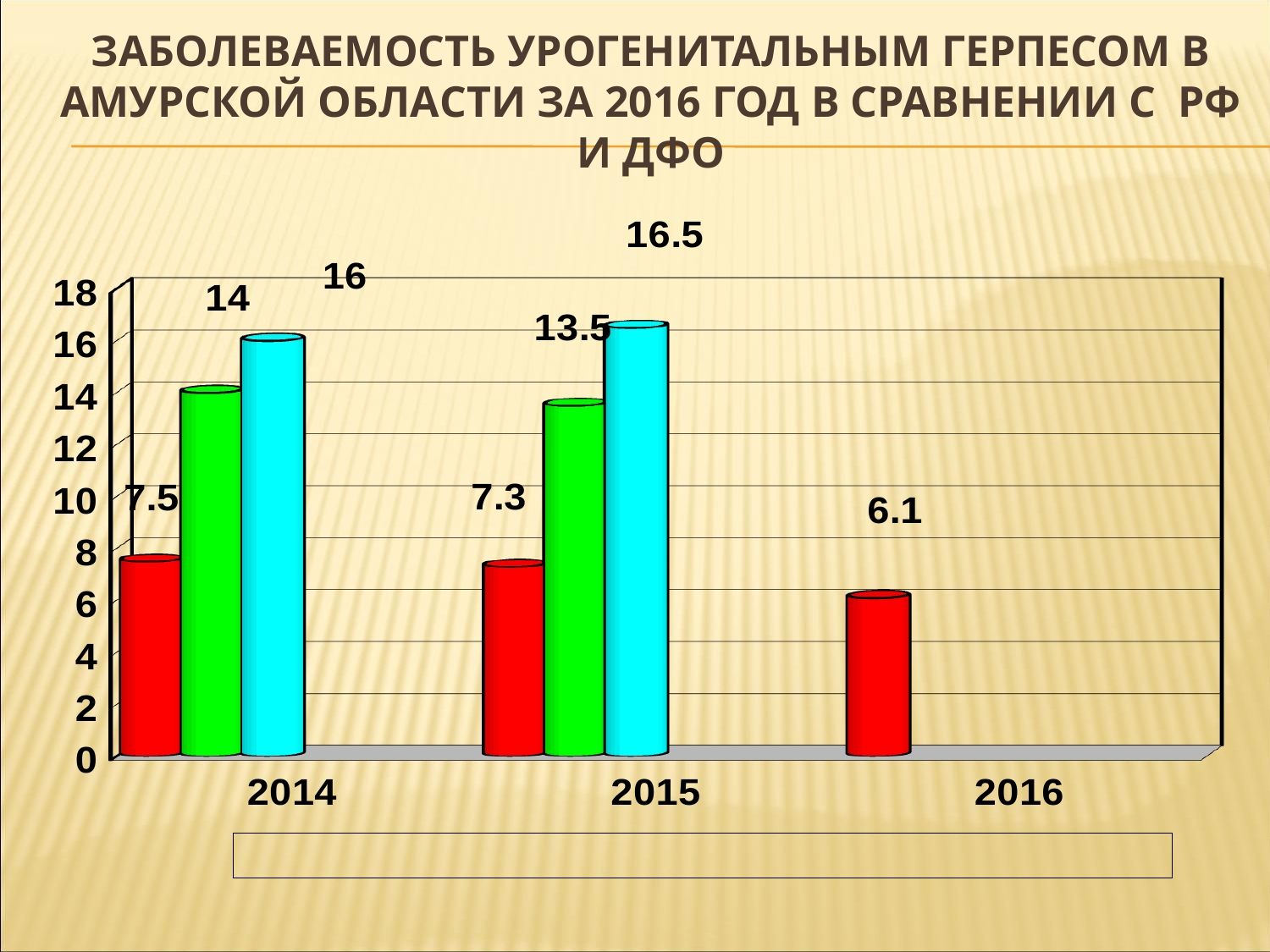
Which year has the highest value for the red bars? 2014 What is the value of the cyan bar for 2015? 16.5 What is the value of the cyan bar for 2014? 16 Which year has the lowest value for the red bars? 2016 What kind of chart is shown on the slide? bar chart What is the value of the red bar for 2016? 6.1 What is the difference between the cyan bar and the red bar for 2015? 9.2 How many years are shown on the x axis? 3 What is the value of the green bar for 2015? 13.5 Do the red bar values rise or fall from 2014 to 2016? fall Which is larger, the green bar for 2014 or the green bar for 2015? the green bar for 2014 What is the value of the red bar for 2014? 7.5